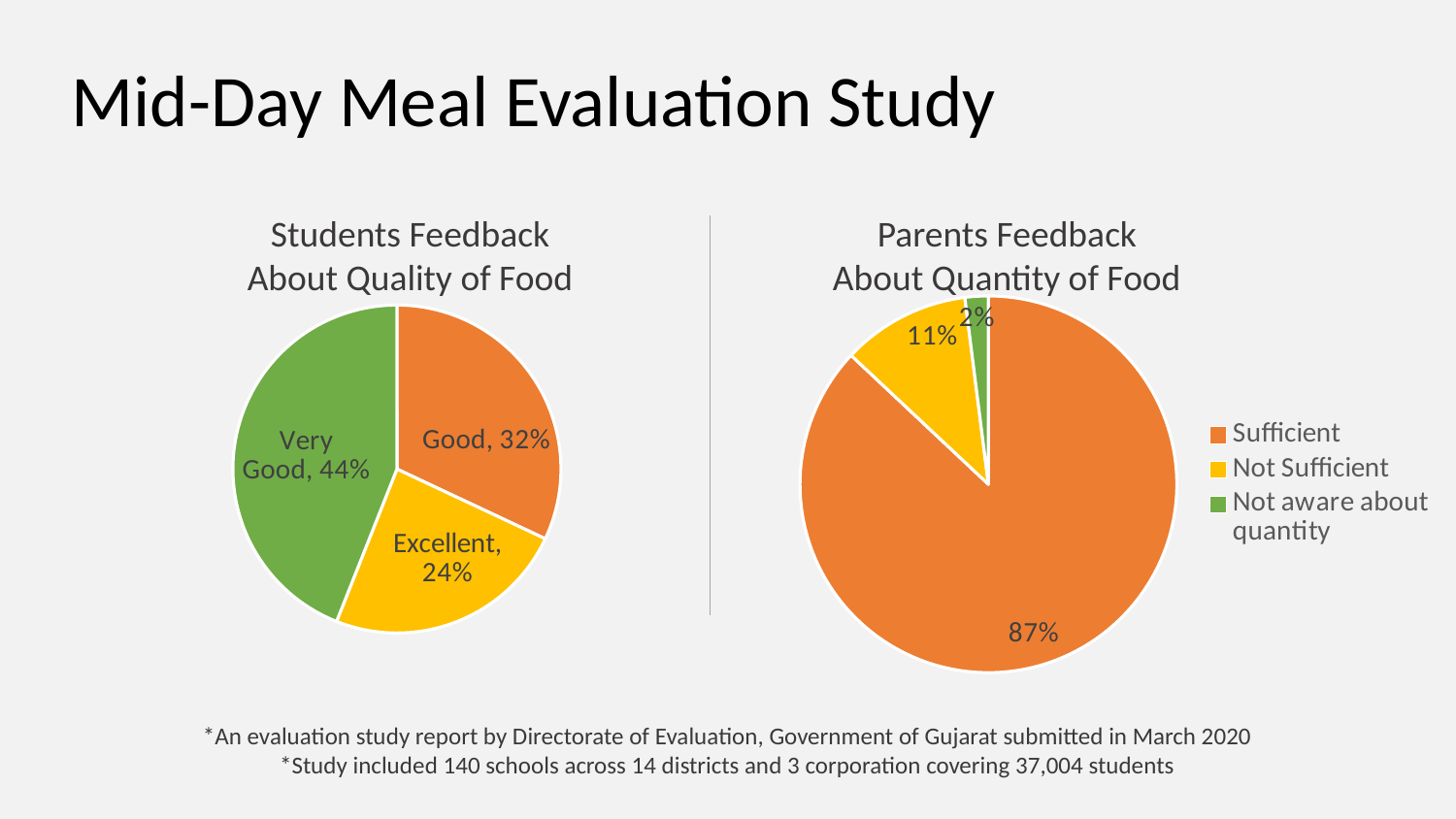
In the 'Parents Feedback About Quantity of Food' chart, what share of parents said the quantity was Not Sufficient? 11% In the 'Students Feedback About Quality of Food' chart, what is the difference between the Very Good and Good shares? 12% In the 'Students Feedback About Quality of Food' chart, which rating has the largest share? Very Good In the 'Parents Feedback About Quantity of Food' chart, which category has the smallest share? Not aware about quantity In the 'Students Feedback About Quality of Food' chart, which rating has the smallest share? Excellent In the 'Parents Feedback About Quantity of Food' chart, what share of parents said the quantity was Sufficient? 87% In the 'Parents Feedback About Quantity of Food' chart, what is the difference between the Sufficient and Not Sufficient shares? 76% In the 'Students Feedback About Quality of Food' chart, how many slices does the pie have? 3 What type of chart is used for the 'Parents Feedback About Quantity of Food' chart? Pie chart In the 'Students Feedback About Quality of Food' chart, what share of students rated the food as Good? 32% In the 'Parents Feedback About Quantity of Food' chart, how many entries does the legend list? 3 In the 'Students Feedback About Quality of Food' chart, what share of students rated the food as Excellent? 24%